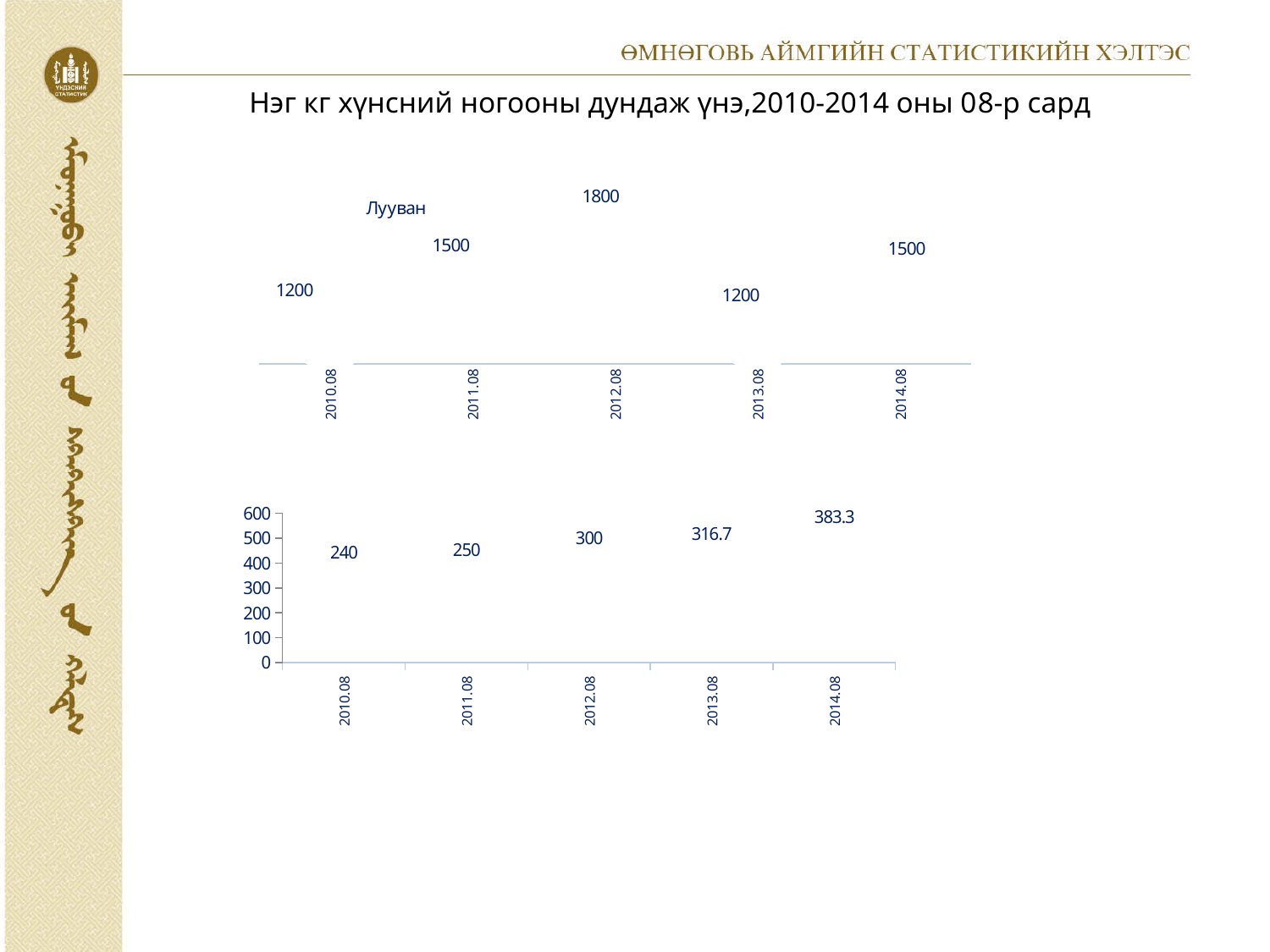
In the bottom chart, which period has the lowest value? 2010.08 In the bottom chart, what is the difference between the values for 2012.08 and 2010.08? 60 In the bottom chart, what is the value for 2013.08? 316.7 In the top chart (Лууван), how many periods are shown on the x axis? 5 In the top chart (Лууван), what is the value for 2010.08? 1200 What is the series label shown on the top chart? Лууван In the bottom chart, what is the value for 2014.08? 383.3 In the bottom chart, which period has the highest value? 2014.08 In the bottom chart, do the values rise or fall from 2010.08 to 2014.08? rise In the top chart (Лууван), what is the value for 2012.08? 1800 In the top chart (Лууван), what is the difference between the values for 2012.08 and 2011.08? 300 In the top chart (Лууван), which period has the highest value? 2012.08